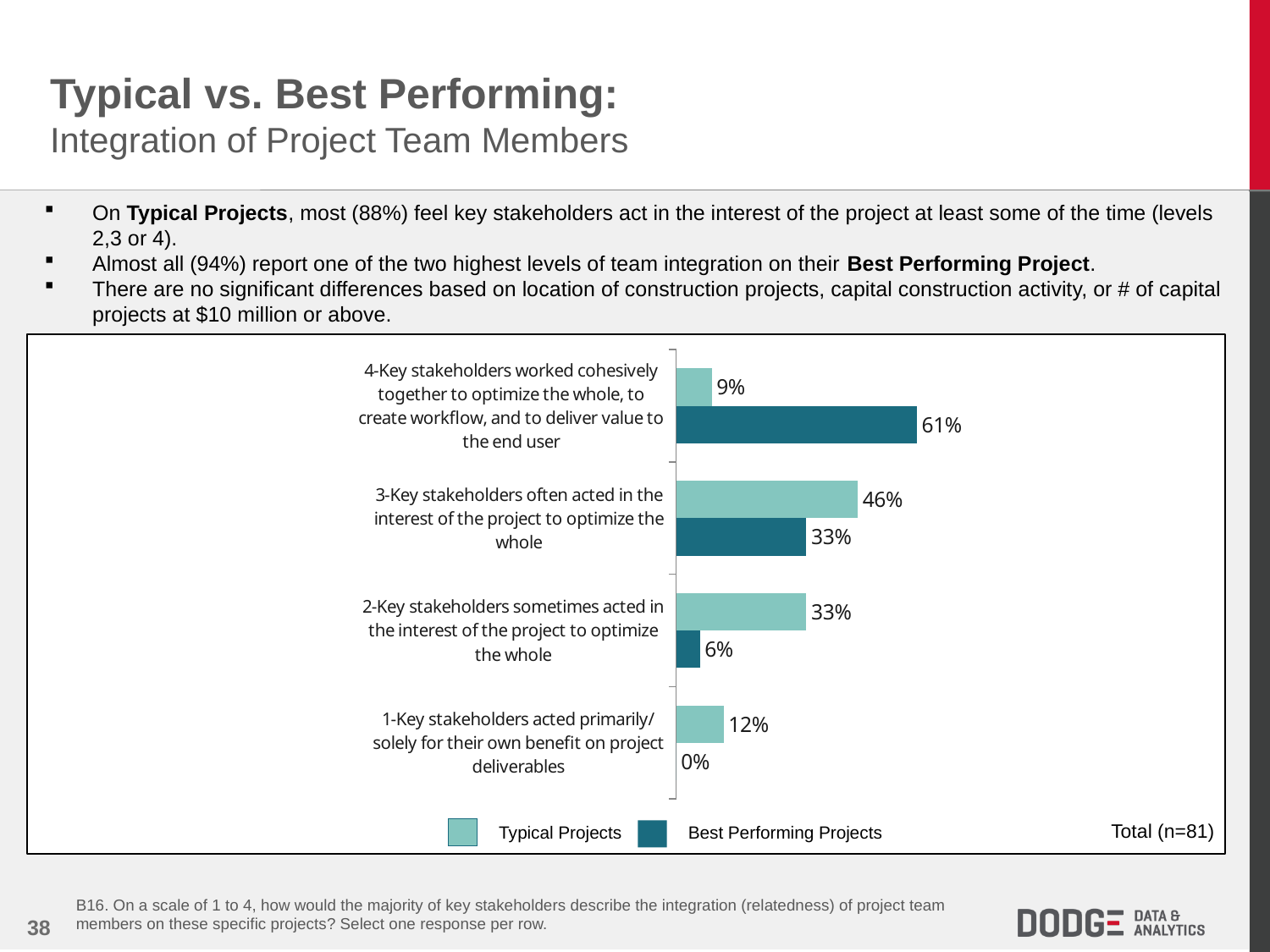
What percentage of Typical Projects are at level 3 (key stakeholders often acted in the interest of the project)? 46% How many categories (integration levels) are shown on the chart? 4 At level 2 (key stakeholders sometimes acted in the interest of the project), which is larger: Typical Projects or Best Performing Projects? Typical Projects How many series does the legend list? 2 What is the difference between Best Performing Projects and Typical Projects at level 4? 52% Which category has the lowest value for Typical Projects? 4-Key stakeholders worked cohesively together to optimize the whole, to create workflow, and to deliver value to the end user Which category has the highest value for Best Performing Projects? 4-Key stakeholders worked cohesively together to optimize the whole, to create workflow, and to deliver value to the end user What percentage of Best Performing Projects are at level 1 (key stakeholders acted primarily/solely for their own benefit)? 0% What percentage of Typical Projects are at level 4 (key stakeholders worked cohesively together to optimize the whole)? 9% What is the sample size (n) shown on the chart? 81 What percentage of Best Performing Projects are at level 4 (key stakeholders worked cohesively together to optimize the whole)? 61% What kind of chart is shown on the slide? Bar chart